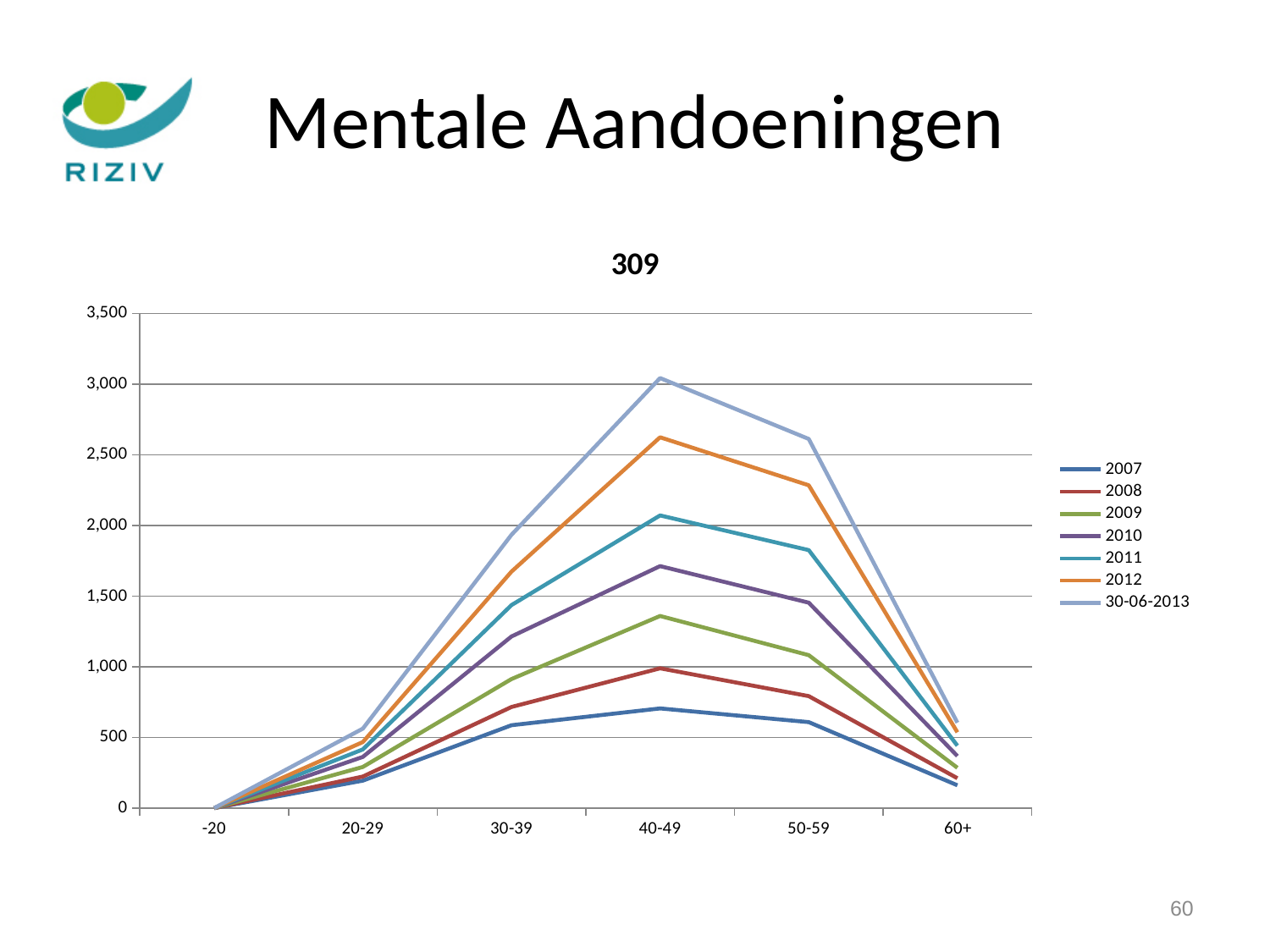
Which series has the highest value at 40-49? 30-06-2013 What kind of chart is shown on the slide? line chart Is the value for 2011 at 50-59 greater or less than 2,000? less For the 2012 series, which age category has the highest value? 40-49 Which series has the lowest value at 40-49? 2007 Do the values for the 2010 series rise or fall from 40-49 to 60+? fall What is the title of the chart? 309 At 50-59, which is larger: the value for 30-06-2013 or the value for 2007? 30-06-2013 How many series does the legend list? 7 How many age categories are shown on the x axis? 6 Is the value for 2009 at 40-49 greater or less than 1,500? less Is the value for 2012 at 40-49 greater or less than 2,500? greater